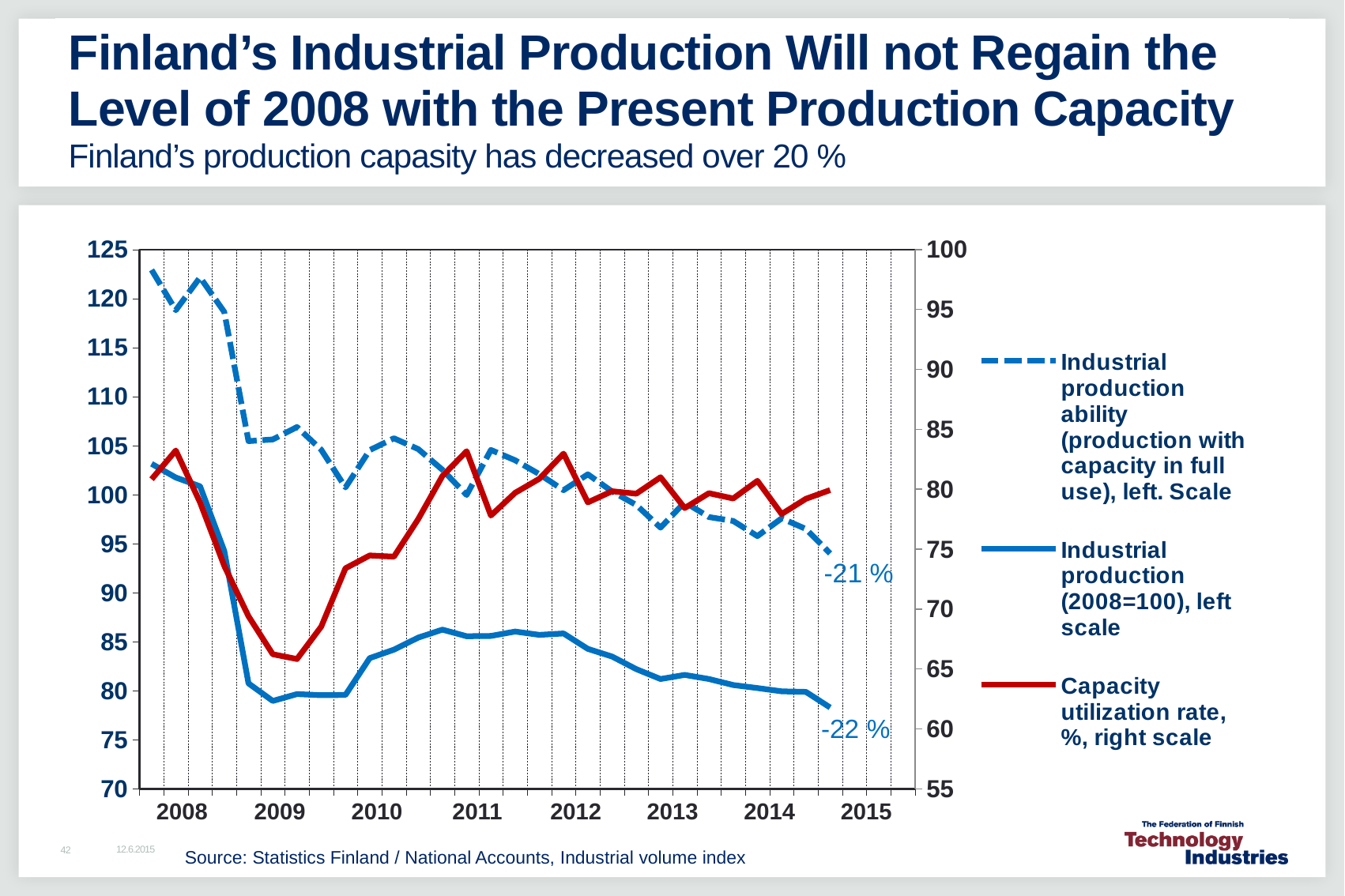
How many series does the legend list? 3 Does the Industrial production ability line rise or fall from 2008 to 2015? fall Is the Capacity utilization rate in early 2009 greater or less than 70 on the right scale? less Is the value of Industrial production ability at the end of the series in 2015 greater or less than 100? less Which of the two blue series has the higher value at the start of 2008: Industrial production ability or Industrial production (2008=100)? Industrial production ability What percentage change is annotated at the end of the Industrial production ability line? -21 % Is the value of Industrial production ability at the start of 2008 greater or less than 120? greater What kind of chart is shown on the slide? line chart Which series is plotted on the right scale? Capacity utilization rate, % Which series is drawn as a dashed line? Industrial production ability (production with capacity in full use) What percentage change is annotated at the end of the Industrial production (2008=100) line? -22 %